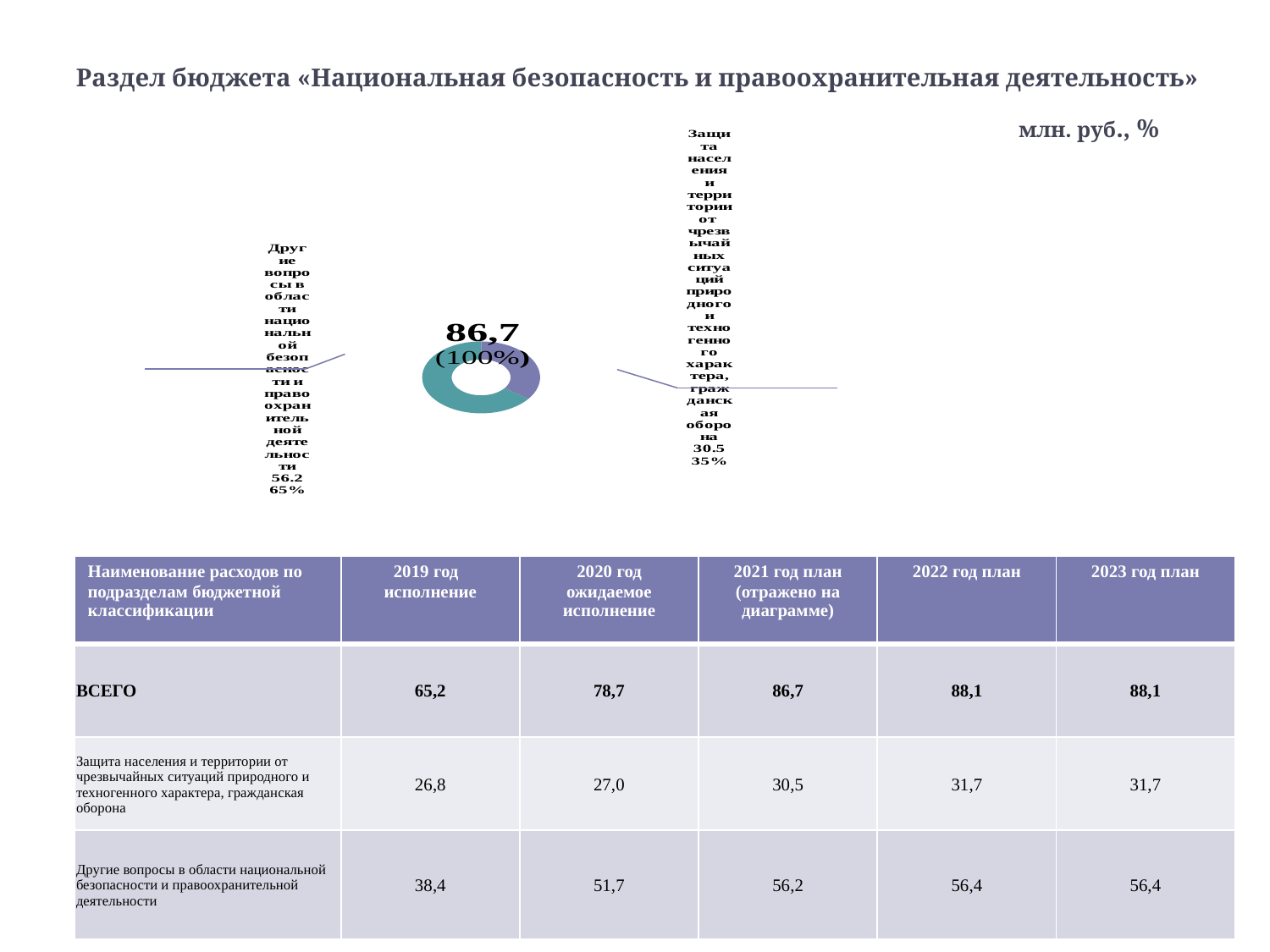
What value is shown for the slice "Другие вопросы в области национальной безопасности и правоохранительной деятельности"? 56.2 How many slices does the doughnut chart have? 2 What value is shown for the slice "Защита населения и территории от чрезвычайных ситуаций природного и техногенного характера, гражданская оборона"? 30.5 Which slice of the doughnut chart is the smallest? Защита населения и территории от чрезвычайных ситуаций природного и техногенного характера, гражданская оборона What unit is indicated for the chart in the top right of the slide? млн. руб., % Which is larger: the slice for "Другие вопросы..." or the slice for "Защита населения..."? Другие вопросы в области национальной безопасности и правоохранительной деятельности What is the difference between the values of the two slices in the doughnut chart (56.2 and 30.5)? 25.7 What share of the doughnut does "Другие вопросы в области национальной безопасности и правоохранительной деятельности" take? 65% What kind of chart is shown on the slide? doughnut chart What total value is printed in the centre of the doughnut chart? 86,7 (100%) Which slice of the doughnut chart is the largest? Другие вопросы в области национальной безопасности и правоохранительной деятельности What share of the doughnut does "Защита населения и территории от чрезвычайных ситуаций природного и техногенного характера, гражданская оборона" take? 35%